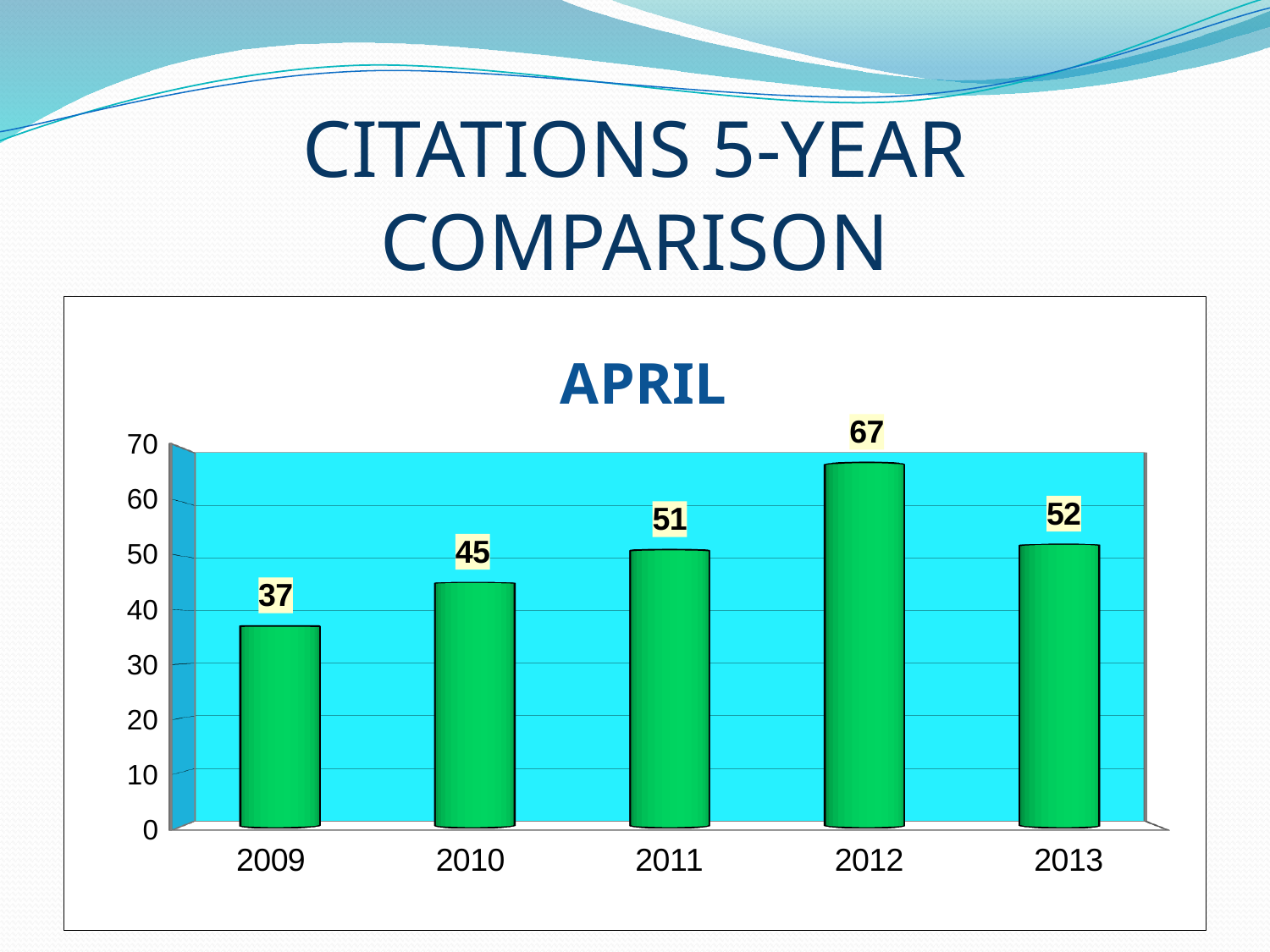
What is the value for 2013? 52 What kind of chart is shown on the slide? bar chart Which is larger, the value for 2013 or the value for 2011? 2013 Which year has the lowest value? 2009 What is the difference between the values for 2011 and 2010? 6 What is the value for 2009? 37 How many years are shown on the chart? 5 Is the value for 2010 greater or less than 40? greater What is the difference between the values for 2012 and 2009? 30 What is the value for 2012? 67 What is the title of the chart? APRIL Which year has the highest value? 2012